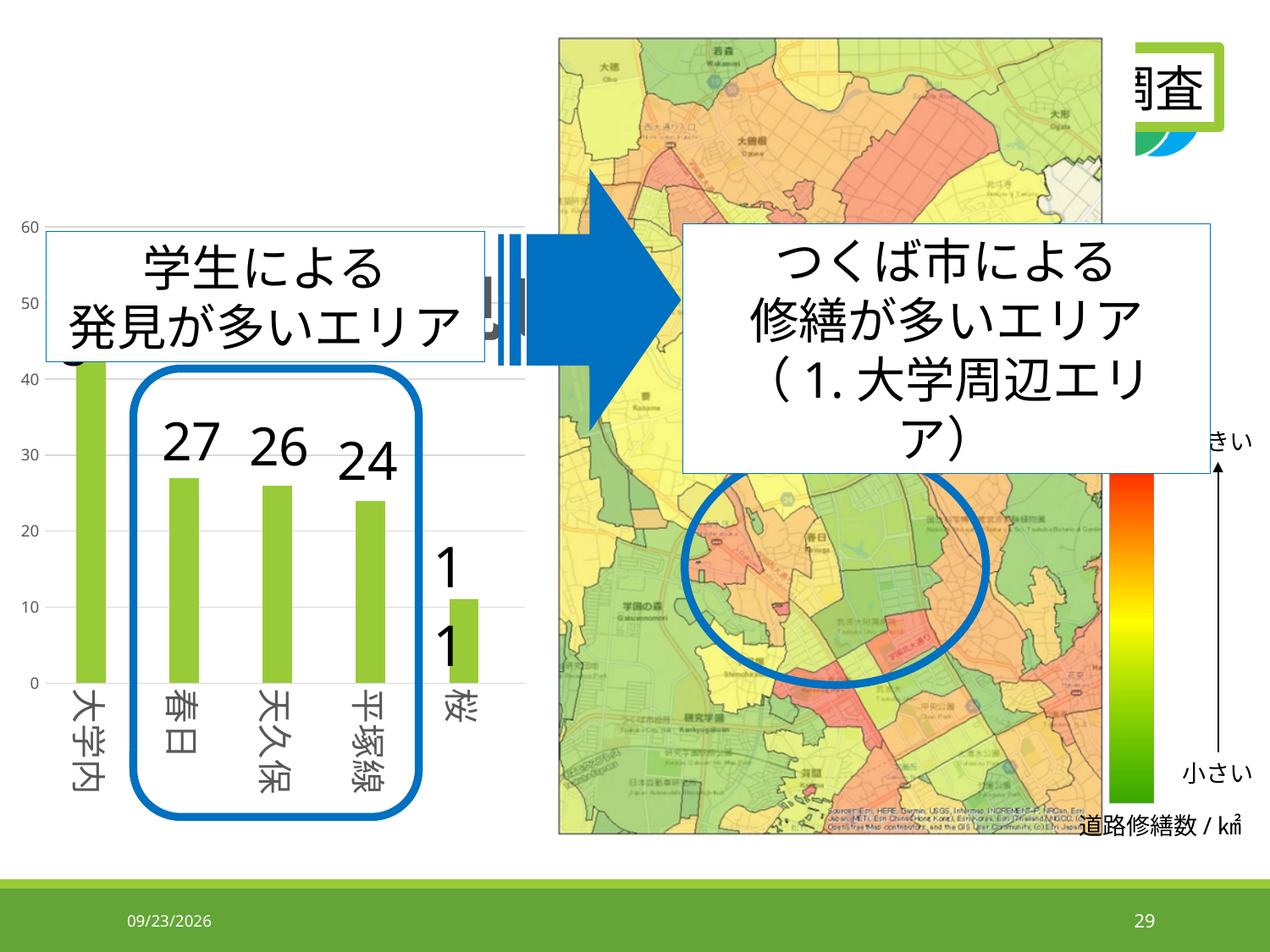
What is the difference between the values for 天久保 and 平塚線? 2 Which category has the lowest bar in the chart? 桜 Is the value for 桜 greater or less than 20? less Is the value for 大学内 greater or less than 40? greater How many categories are shown on the x axis of the bar chart? 5 Which is larger, the value for 春日 or the value for 天久保? 春日 What is the difference between the values for 春日 and 平塚線? 3 Which category has the highest bar in the chart? 大学内 What kind of chart is shown on the left of the slide? bar chart What is the value for 春日 in the bar chart? 27 What is the value for 天久保 in the bar chart? 26 What is the value for 平塚線 in the bar chart? 24